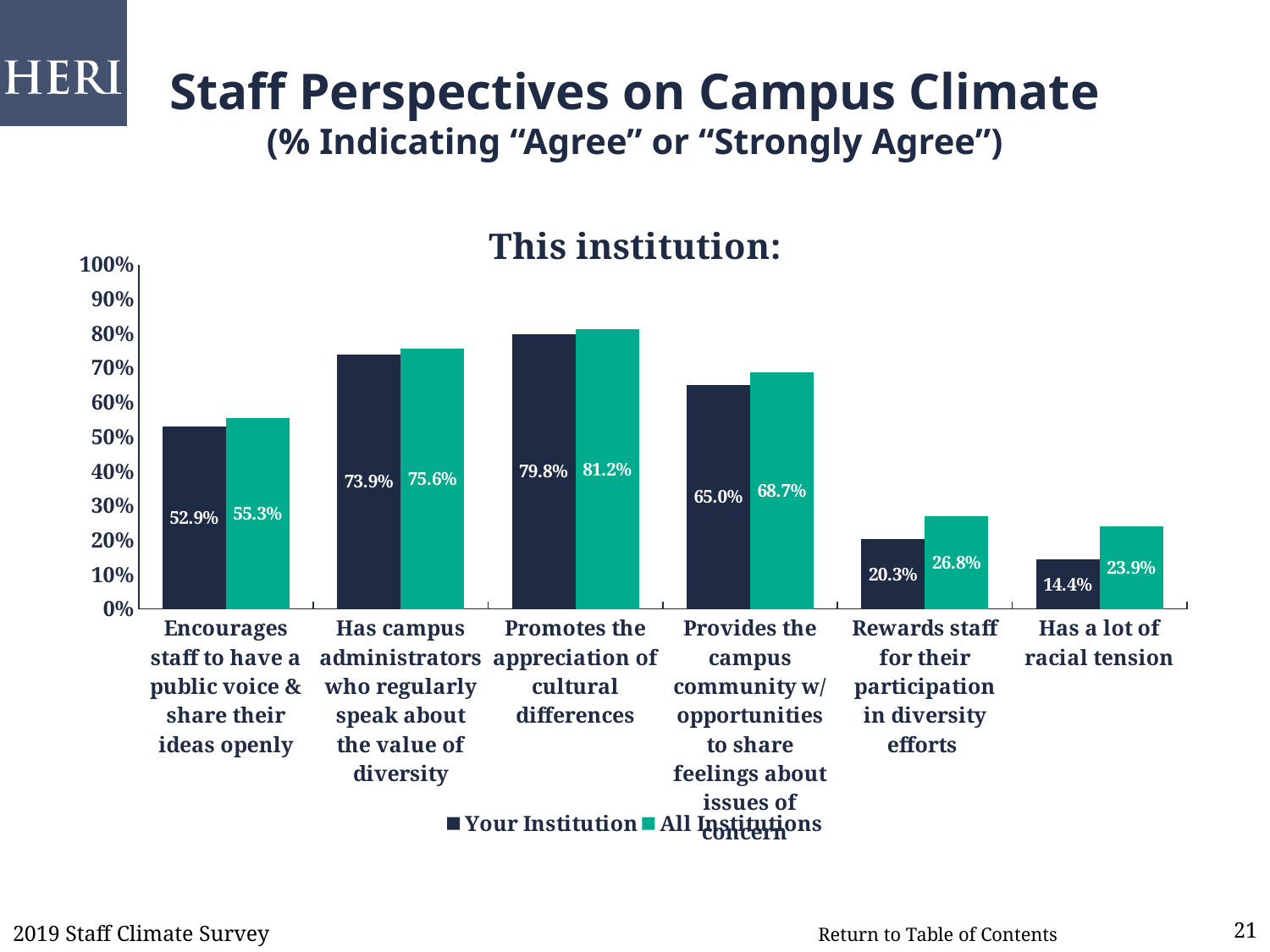
What is the title of the chart? This institution: How many categories are shown on the x axis? 6 Which category has the highest value for Your Institution? Promotes the appreciation of cultural differences What kind of chart is shown on the slide? Bar chart What is the value for All Institutions for "Has a lot of racial tension"? 23.9% What is the value for Your Institution for "Promotes the appreciation of cultural differences"? 79.8% What is the value for Your Institution for "Rewards staff for their participation in diversity efforts"? 20.3% Which category has the lowest value for All Institutions? Has a lot of racial tension How many series does the legend list? 2 What is the difference between All Institutions and Your Institution for "Provides the campus community w/ opportunities to share feelings about issues of concern"? 3.7% Is the value for Your Institution for "Has campus administrators who regularly speak about the value of diversity" greater or less than 70%? greater Which is larger for "Encourages staff to have a public voice & share their ideas openly": Your Institution or All Institutions? All Institutions